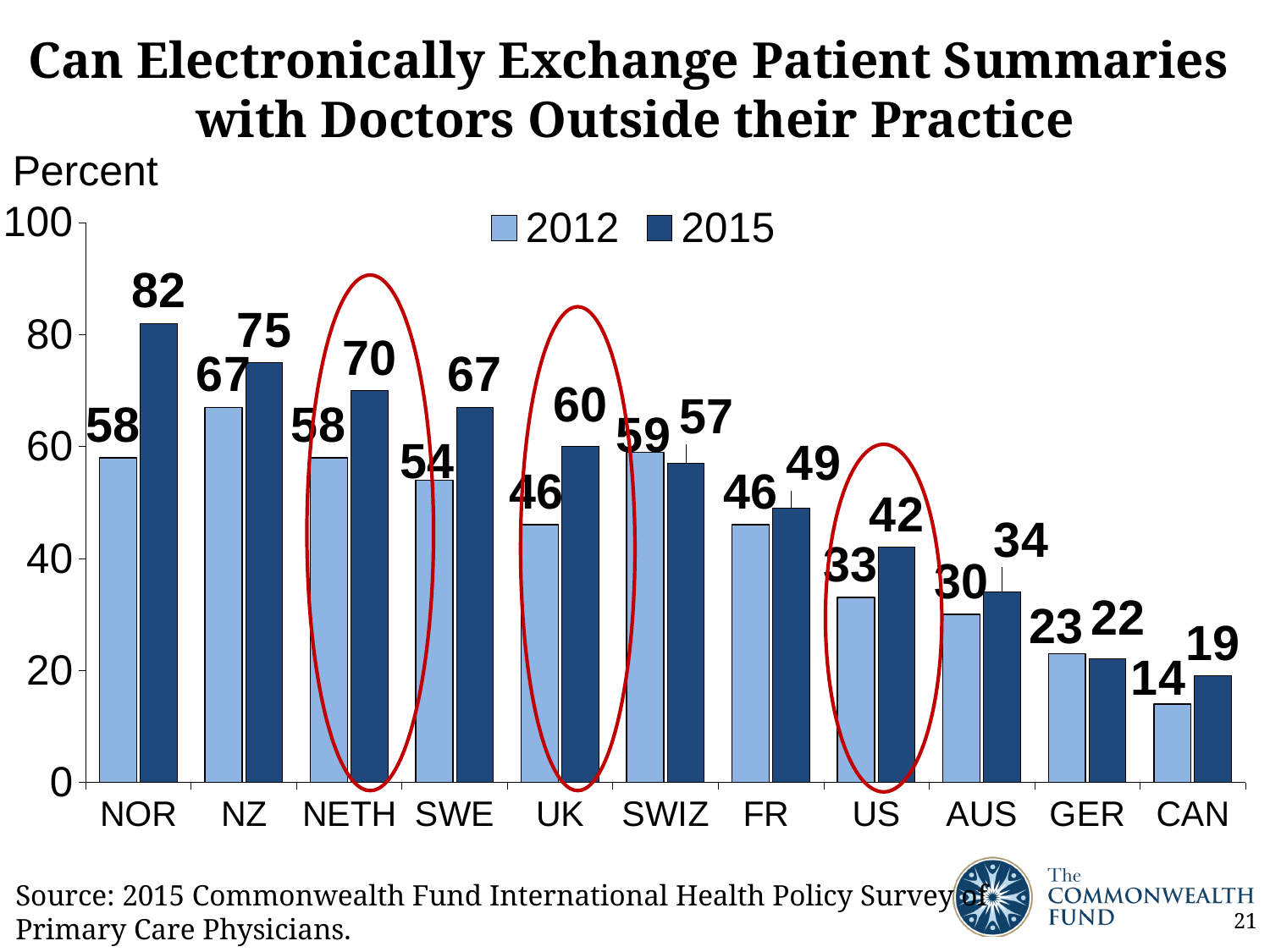
Is the 2015 value for AUS greater or less than 40? less Which country has the highest 2015 value? NOR What is the difference between the 2015 and 2012 values for NETH? 12 How many countries are shown on the x axis? 11 What kind of chart is shown on the slide? bar chart What is the 2015 value for NOR? 82 For SWIZ, which is larger, the 2012 value or the 2015 value? 2012 What is the 2015 value for the US? 42 Which country has the lowest 2012 value? CAN How many series does the legend list? 2 What is the 2012 value for the UK? 46 Which years are listed in the legend? 2012 and 2015